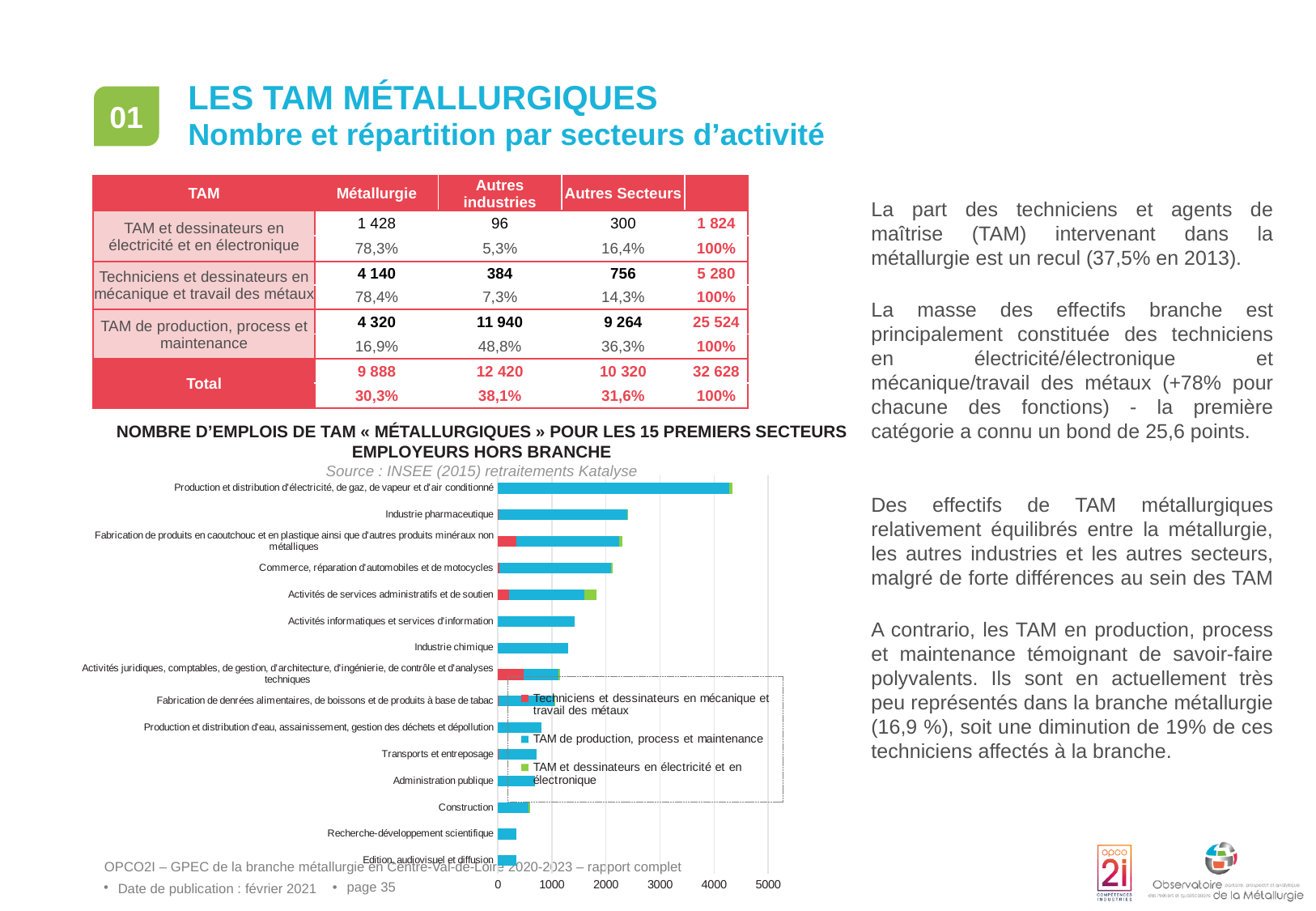
Is the total bar for 'Activités informatiques et services d'information' greater or less than 2000? less Is the total bar for 'Production et distribution d'électricité, de gaz, de vapeur et d'air conditionné' greater or less than 4000? greater How many sectors (categories) are plotted in the bar chart? 15 Which bar is longer: 'Industrie pharmaceutique' or 'Industrie chimique'? Industrie pharmaceutique Is the total bar for 'Industrie pharmaceutique' greater or less than 2000? greater Which sector has the longest bar in the chart? Production et distribution d'électricité, de gaz, de vapeur et d'air conditionné What source is cited under the bar chart's title? INSEE (2015) retraitements Katalyse What kind of chart is shown on the slide? Bar chart (stacked horizontal bars) Going from the top of the chart to the bottom, do the bar lengths increase or decrease? decrease How many series does the legend of the bar chart list? 3 Which series in the bar chart is shown in blue? TAM de production, process et maintenance